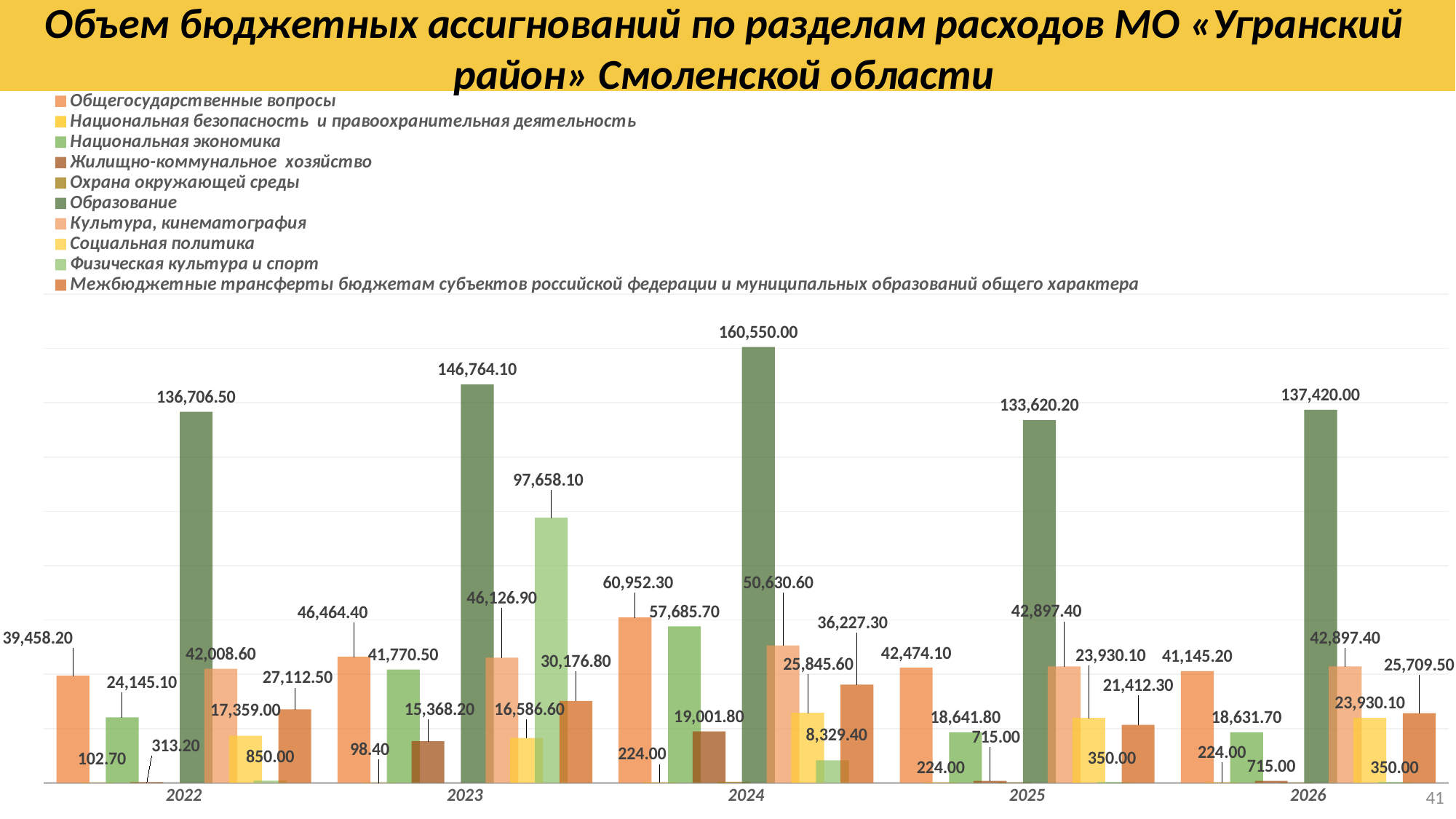
From 2022 to 2024, does the value for Общегосударственные вопросы rise or fall? Rise What is the difference between the Образование values for 2024 and 2025? 26,929.80 What is the value for Физическая культура и спорт in 2023? 97,658.10 How many years are shown along the x axis? 5 What is the value for Образование in 2024? 160,550.00 Which is larger in 2023: Физическая культура и спорт or Национальная экономика? Физическая культура и спорт What is the value for Общегосударственные вопросы in 2022? 39,458.20 In which year is the value for Образование the highest? 2024 In which year is the value for Образование the lowest? 2025 What is the value for Межбюджетные трансферты in 2026? 25,709.50 What kind of chart is shown on the slide? Bar chart How many series does the legend list? 10